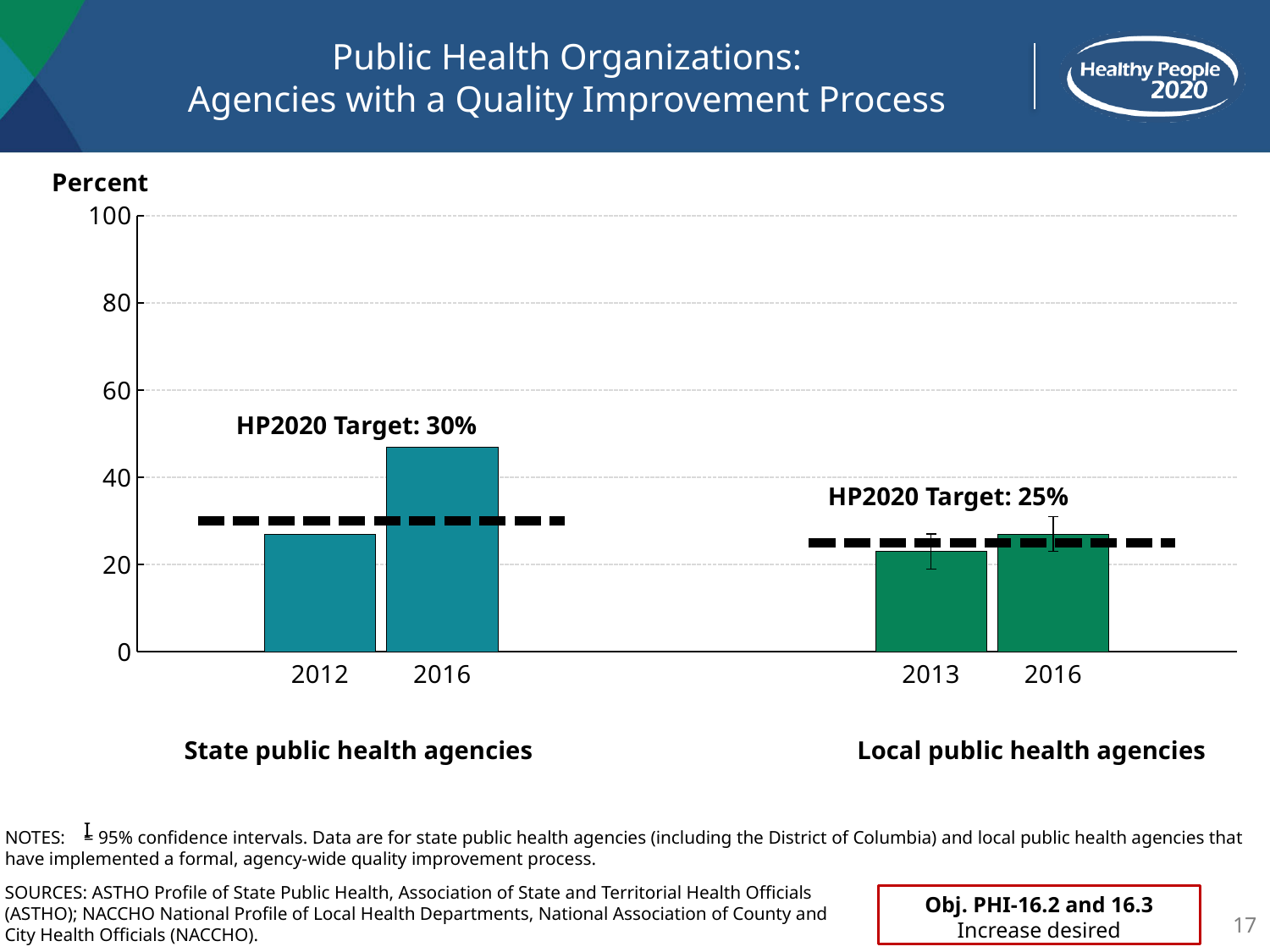
How many bars are plotted on the chart? 4 What is the HP2020 Target shown for state public health agencies? 30% Which is larger for state public health agencies: the 2012 value or the 2016 value? 2016 Which is larger for local public health agencies: the 2013 value or the 2016 value? 2016 What is the label on the vertical axis of the chart? Percent Is the value for state public health agencies in 2016 greater or less than 40? greater Which bar has the highest value on the chart? State public health agencies, 2016 What is the HP2020 Target shown for local public health agencies? 25% What kind of chart is shown on the slide? bar chart Is the value for local public health agencies in 2013 greater or less than 40? less Did the value for state public health agencies rise or fall from 2012 to 2016? rise Is the value for state public health agencies in 2012 greater or less than 40? less